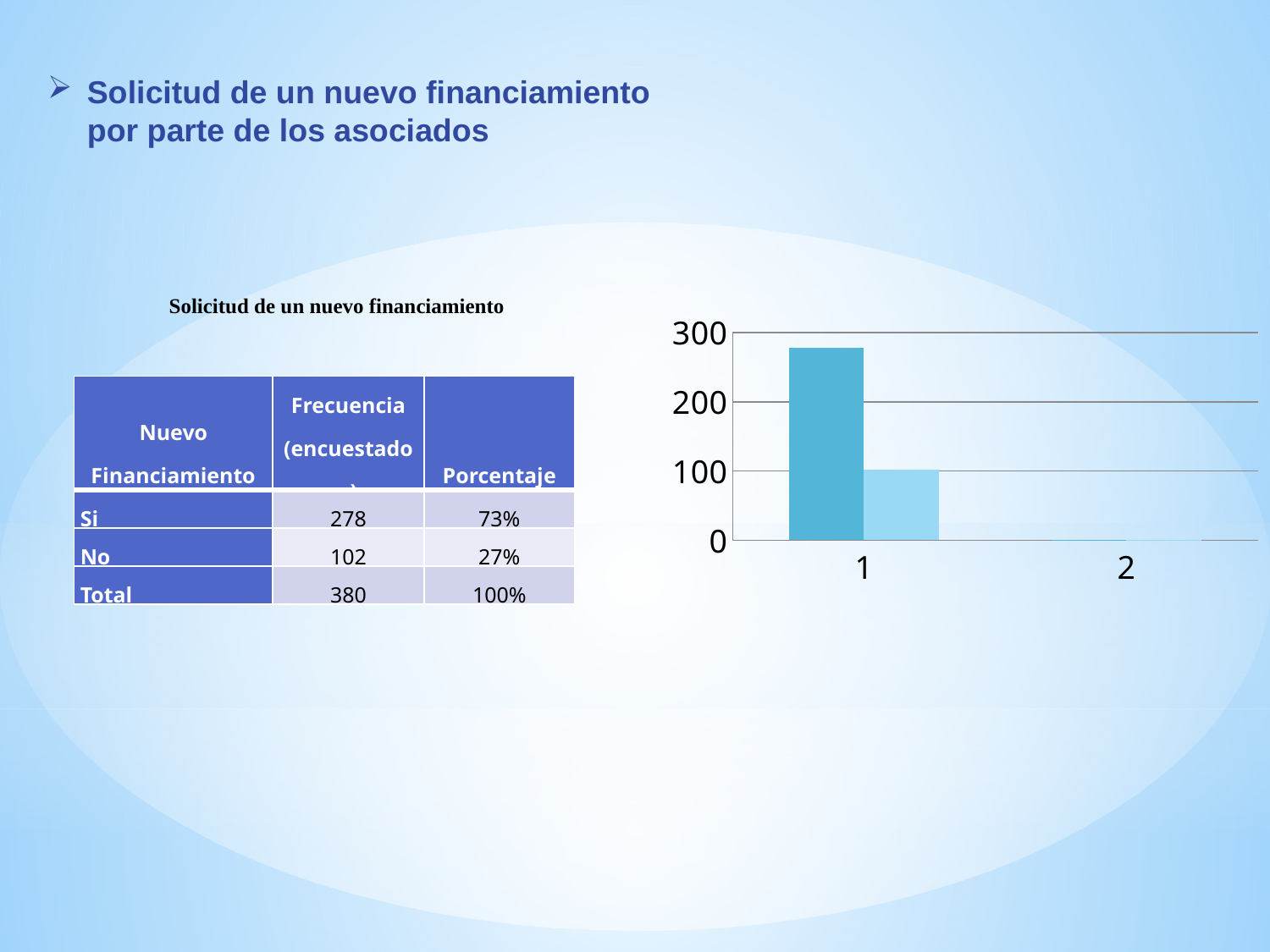
In the bar chart, is the taller bar at category 1 greater or less than 300? less In the bar chart, at category 1, which bar is taller: the darker blue bar or the lighter blue bar? the darker blue bar How many categories are labelled on the x axis of the bar chart? 2 In the bar chart, which x-axis category has the lowest bars? 2 In the bar chart, which x-axis category has the tallest bar? 1 What is the highest value labelled on the y axis of the bar chart? 300 Do the bar heights rise or fall from category 1 to category 2 in the bar chart? fall In the bar chart, is the shorter (lighter blue) bar at category 1 greater or less than 200? less In the bar chart, is the taller bar at category 1 greater or less than 200? greater Does the bar chart display a legend? No What kind of chart is shown on the right of the slide? bar chart